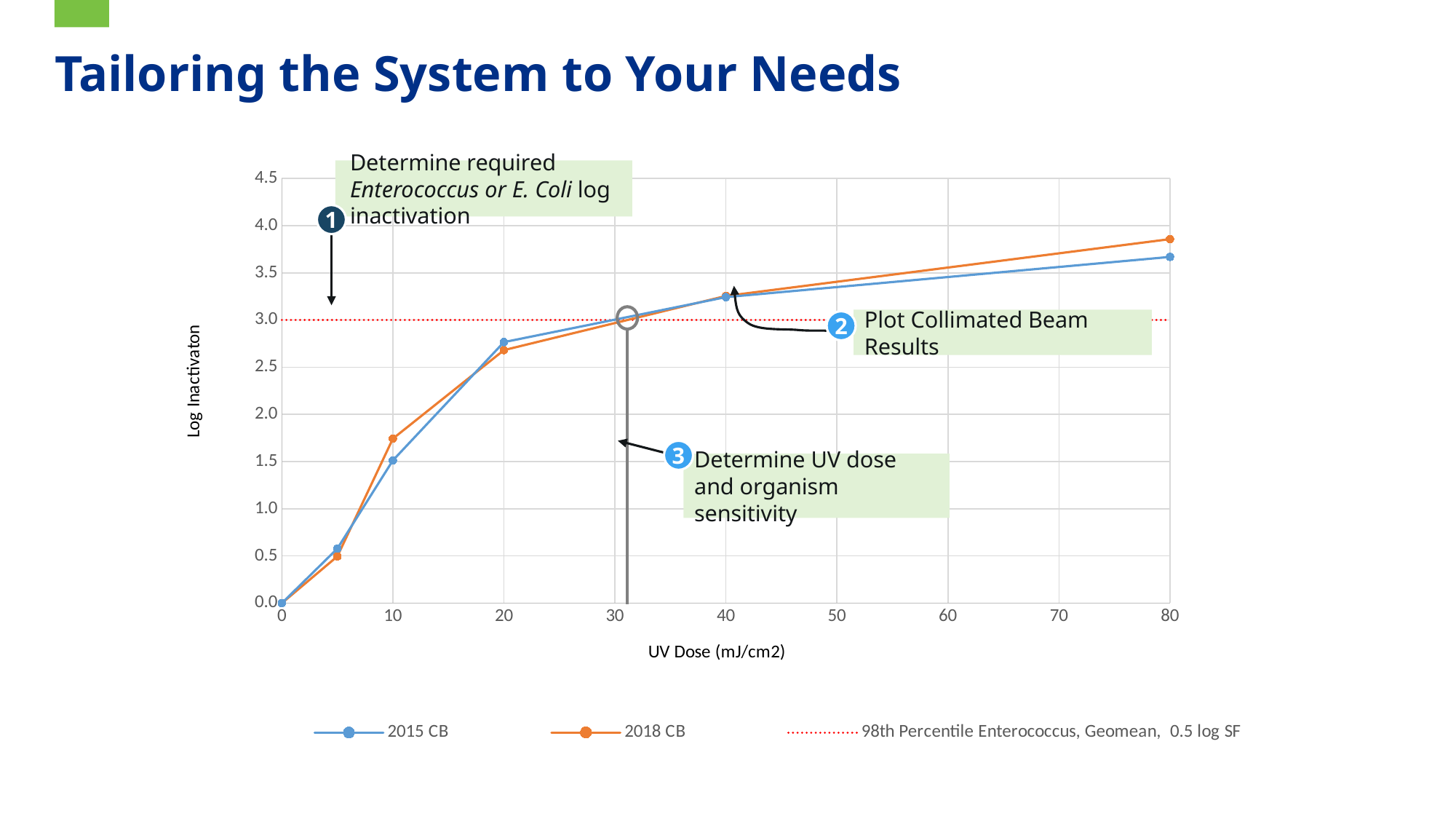
How many entries does the chart legend list? 3 What is the title of the x axis? UV Dose (mJ/cm2) Is the 2018 CB value at a UV dose of 80 greater or less than 3.5? greater Is the 2015 CB value at a UV dose of 10 greater or less than 2.0? less At a UV dose of 10, which series has the higher log inactivation, 2015 CB or 2018 CB? 2018 CB What is the log inactivation for 2015 CB at a UV dose of 0? 0.0 Do the 2018 CB values rise or fall as UV dose increases along the x axis? rise At a UV dose of 80, which series has the higher log inactivation, 2015 CB or 2018 CB? 2018 CB At what log inactivation level is the dotted red reference line drawn? 3.0 How many data points are plotted for the 2015 CB series? 6 Is the 2018 CB value at a UV dose of 20 greater or less than 2.5? greater What kind of chart is shown on the slide? line chart